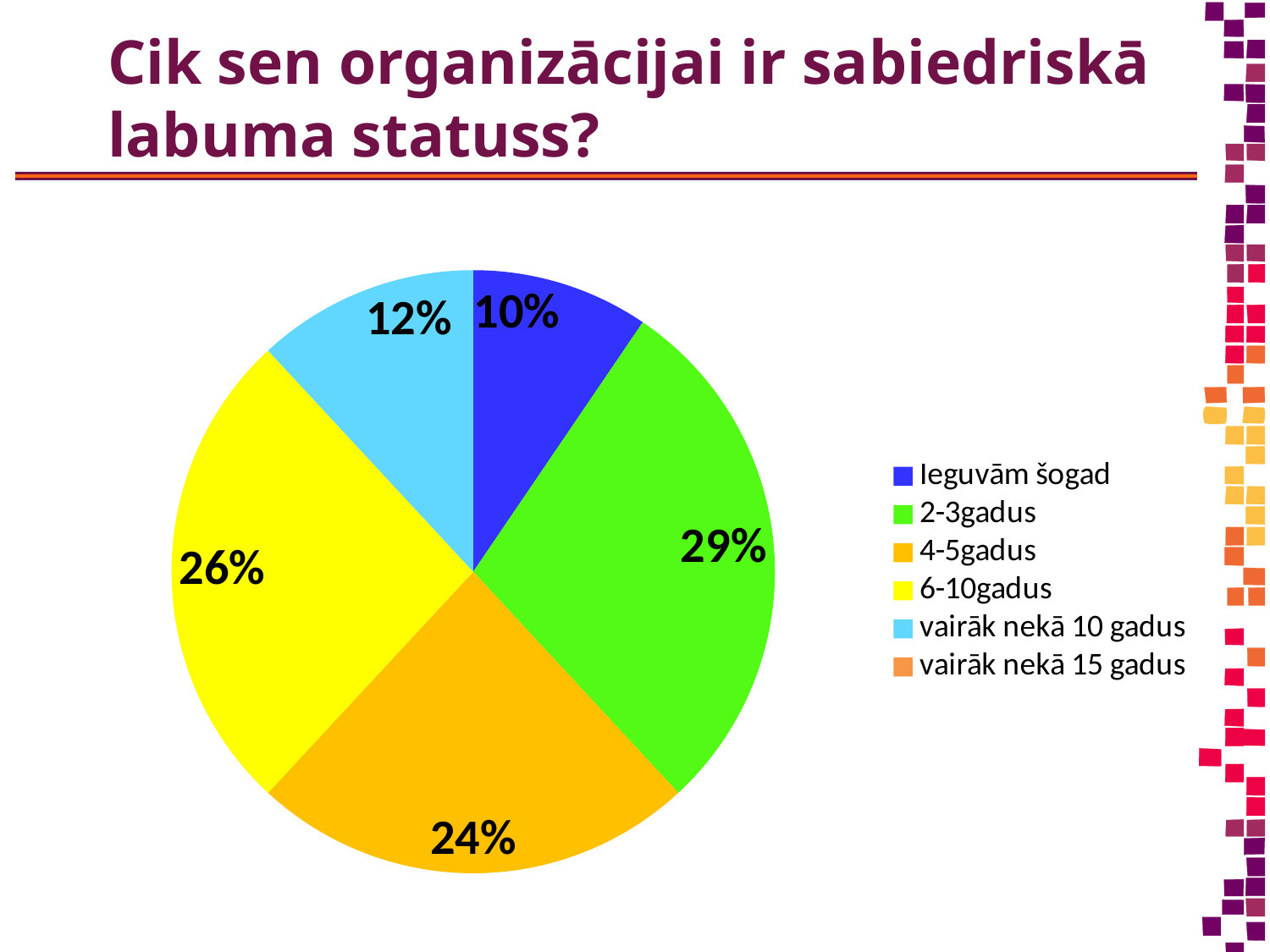
What is the difference in percentage points between the "6-10gadus" slice and the "4-5gadus" slice? 2 What percentage is shown for the "6-10gadus" slice? 26% Which is larger, the "vairāk nekā 10 gadus" slice or the "Ieguvām šogad" slice? vairāk nekā 10 gadus What colour is the "6-10gadus" slice? yellow What kind of chart is shown on the slide? pie chart What percentage is shown for the "2-3gadus" slice? 29% How many entries does the legend list? 6 Which category has the largest slice of the pie? 2-3gadus Which labelled slice of the pie is the smallest? Ieguvām šogad What percentage is shown for the "Ieguvām šogad" slice? 10% What percentage is shown for the "4-5gadus" slice? 24% What percentage is shown for the "vairāk nekā 10 gadus" slice? 12%